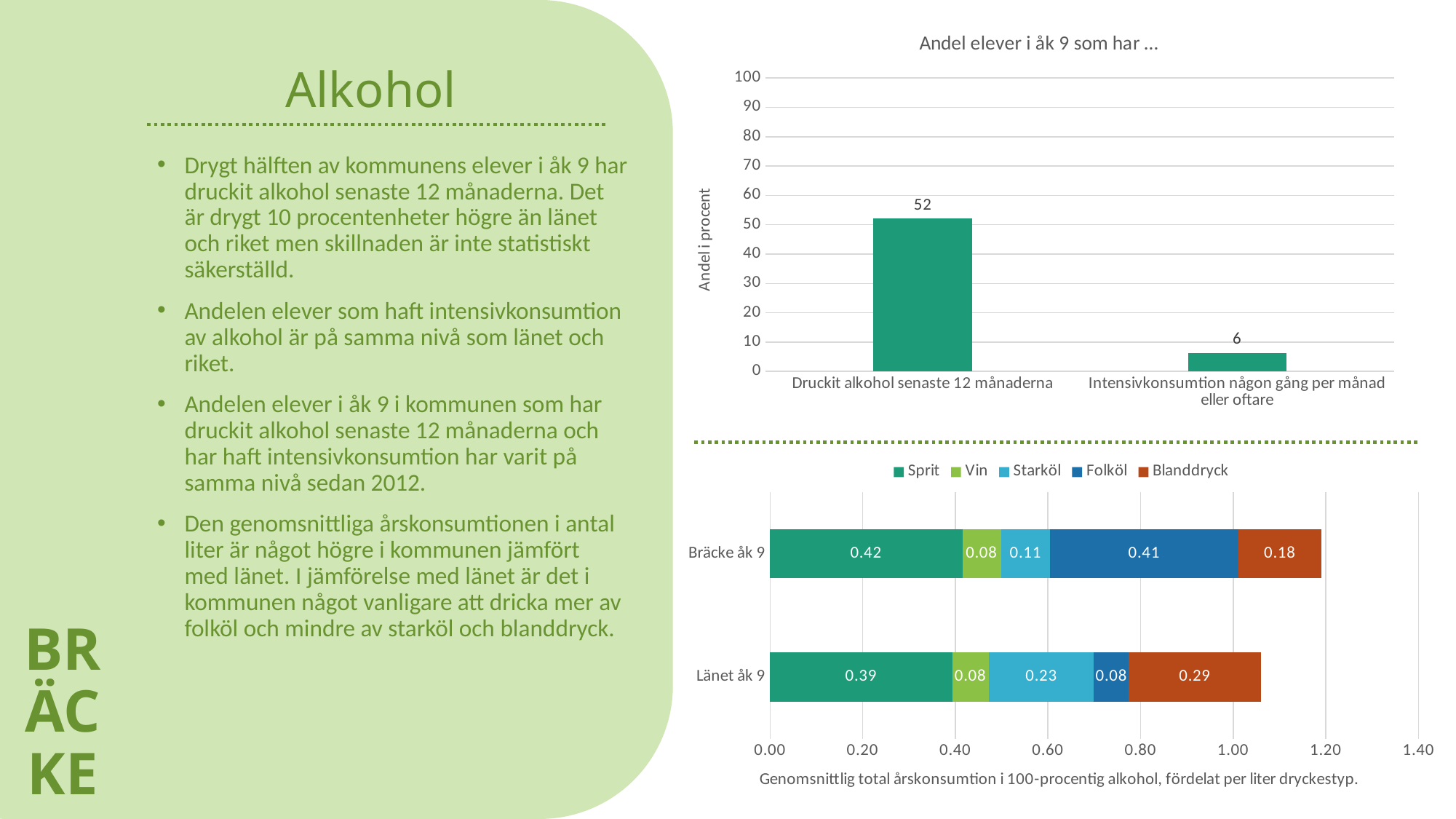
In the bottom stacked bar chart, what is the difference between the Sprit values for Bräcke åk 9 and Länet åk 9? 0.03 In the top chart 'Andel elever i åk 9 som har …', what is the value for 'Druckit alkohol senaste 12 månaderna'? 52 In the top chart 'Andel elever i åk 9 som har …', what is the difference between the two bars? 46 What kind of chart is the top chart 'Andel elever i åk 9 som har …'? Bar chart In the bottom stacked bar chart, how many series does the legend list? 5 In the bottom stacked bar chart, which is larger: the Starköl value for Bräcke åk 9 or for Länet åk 9? Länet åk 9 In the top chart 'Andel elever i åk 9 som har …', how many categories are shown? 2 In the bottom stacked bar chart, what is the total of the Länet åk 9 bar? 1.07 In the bottom stacked bar chart, what is the Blanddryck value for Länet åk 9? 0.29 In the bottom stacked bar chart, what is the Folköl value for Bräcke åk 9? 0.41 In the top chart 'Andel elever i åk 9 som har …', what is the value for 'Intensivkonsumtion någon gång per månad eller oftare'? 6 In the bottom stacked bar chart, what is the total of the Bräcke åk 9 bar? 1.20